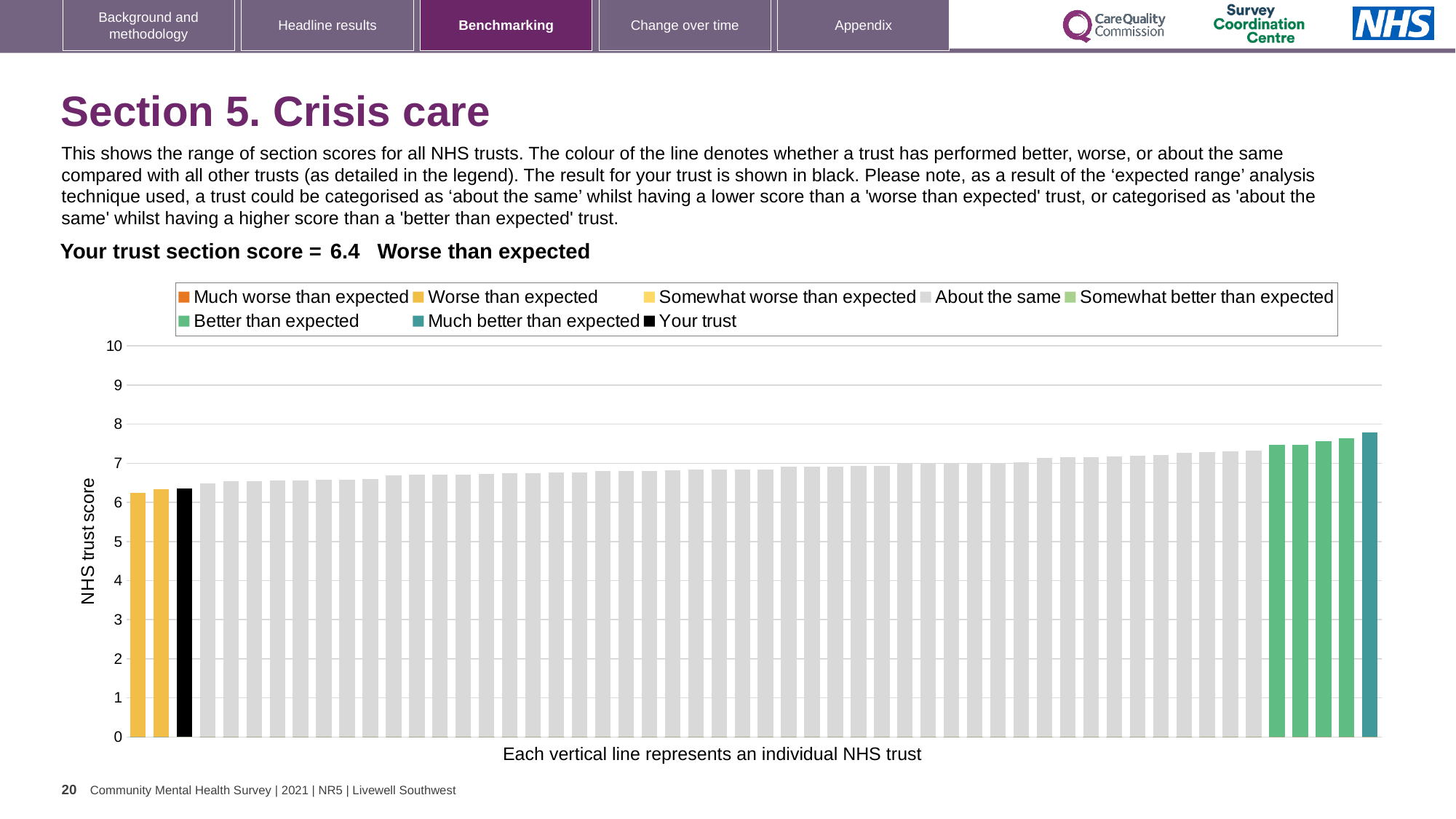
Which legend category does the tallest bar in the chart belong to? Much better than expected What is the label on the vertical axis of the chart? NHS trust score What kind of chart is shown on the slide? Bar chart Do the bar values rise or fall moving from left to right along the x axis? Rise Is the value of the black 'Your trust' bar greater or less than 6? greater Which legend category is your trust's section score placed in? Worse than expected Which is larger: the value of the 'Your trust' bar or the value of the rightmost bar? The rightmost bar What is the section score for your trust shown on the slide? 6.4 How many entries does the chart legend list? 8 How many bars are coloured as 'Worse than expected' (yellow)? 2 Is the value of the tallest bar in the chart greater or less than 8? less Is the value of the tallest bar in the chart greater or less than 7? greater